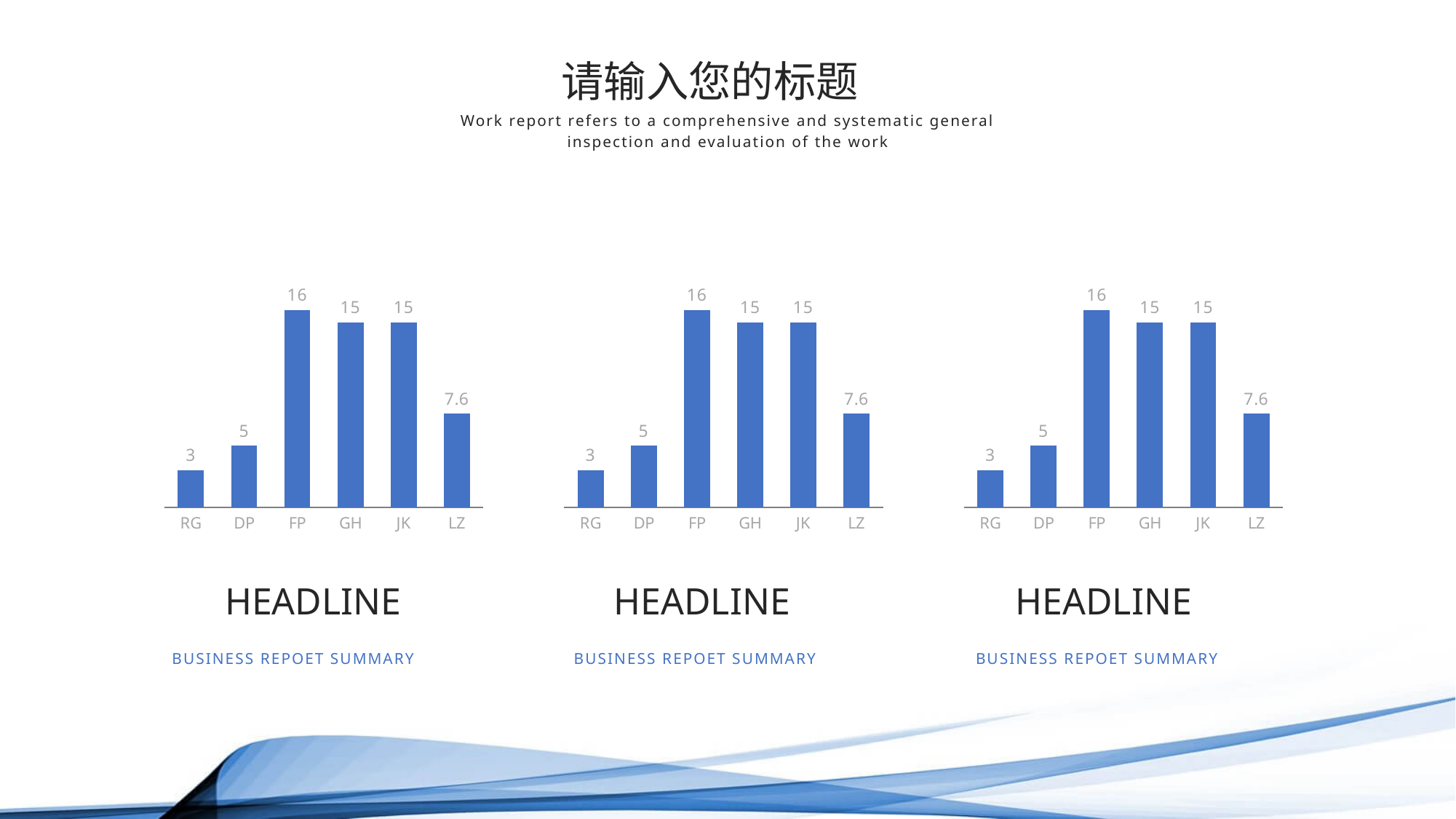
In the middle chart, which category has the lowest value? RG How many categories are shown in the right chart? 6 In the left chart, which category has the highest value? FP In the left chart, what is the value for FP? 16 How many bar charts are shown on the slide? 3 In the middle chart, which is larger, the value for DP or the value for LZ? LZ In the middle chart, what is the value for GH? 15 In the right chart, what is the value for RG? 3 In the middle chart, what is the value for LZ? 7.6 In the right chart, what is the difference between the values for FP and DP? 11 What kind of chart is the left chart? Bar chart In the left chart, what is the difference between the values for LZ and RG? 4.6